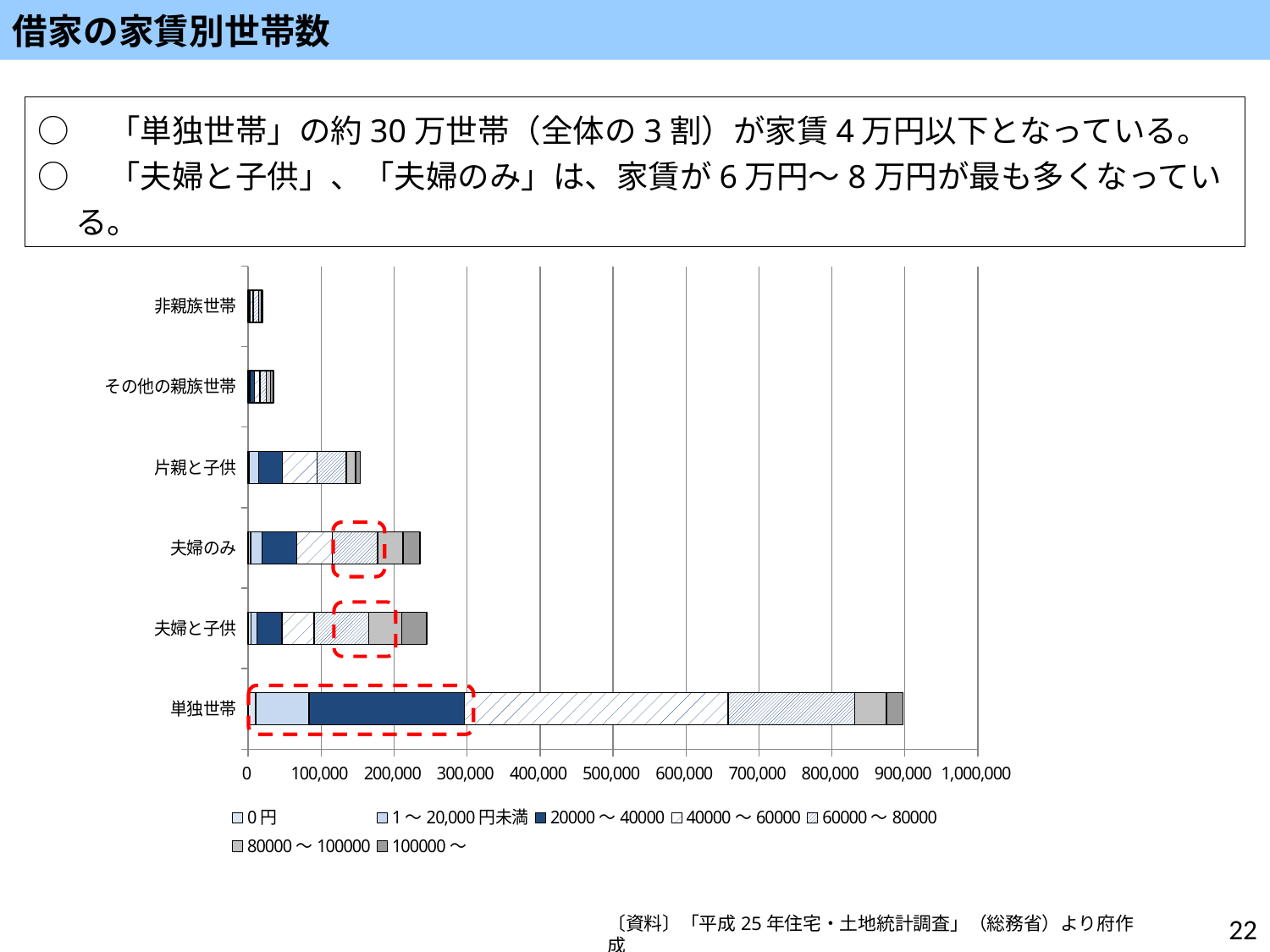
What is the first entry listed in the chart legend? 0円 Which household category has the largest total number of households? 単独世帯 Is the total value for 夫婦と子供 greater or less than 200,000? greater How many household categories are plotted on the chart? 6 How many series does the legend list? 7 What kind of chart is shown on the slide? Stacked bar chart Which has a larger total, 単独世帯 or 夫婦と子供? 単独世帯 Is the total value for 単独世帯 greater or less than 800,000? greater Which household category has the smallest total number of households? 非親族世帯 What is the title of the slide containing the chart? 借家の家賃別世帯数 Is the total value for その他の親族世帯 greater or less than 100,000? less